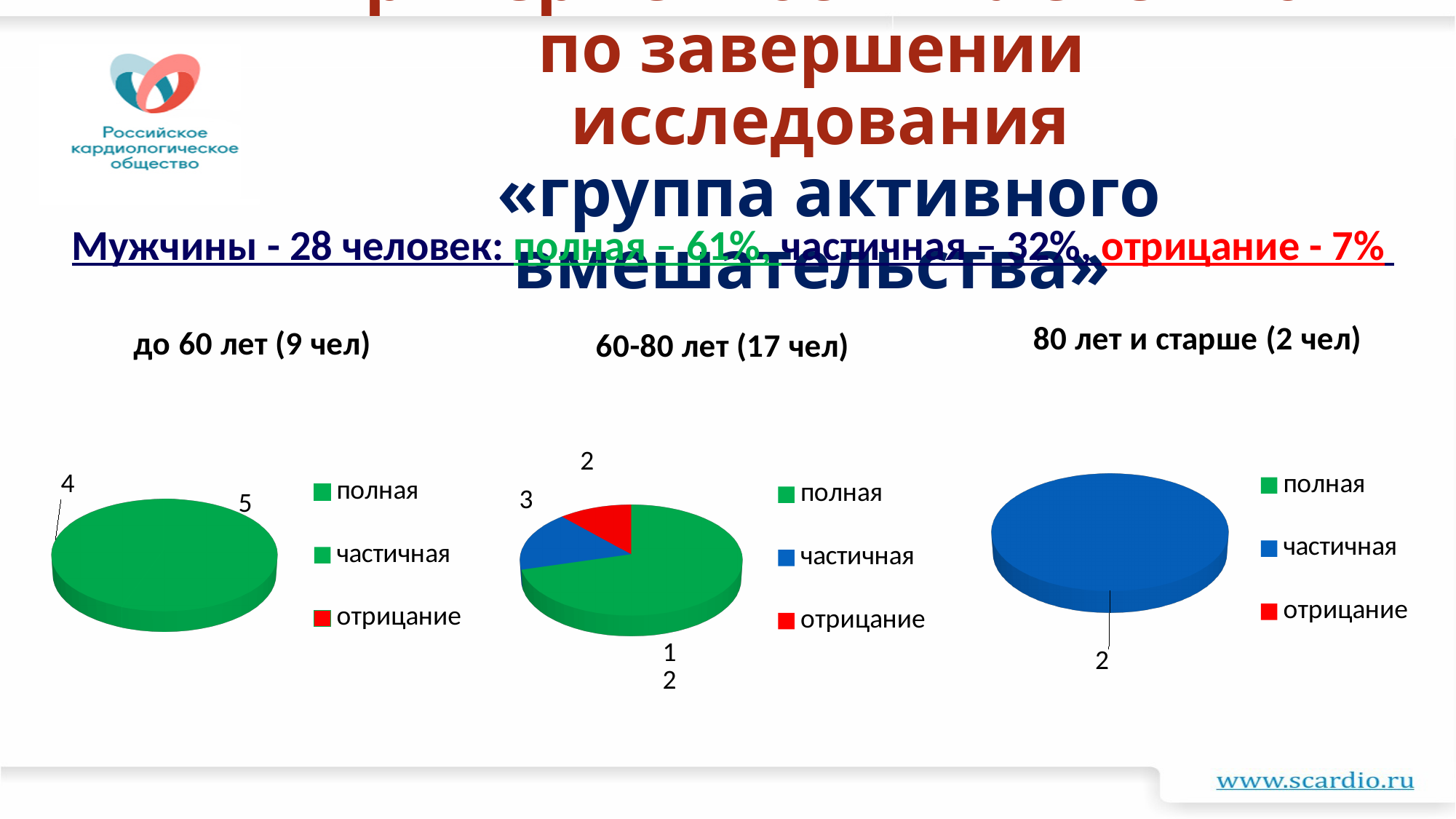
In the "60-80 лет (17 чел)" chart, what is the value for отрицание? 2 Which colour represents отрицание in the chart legends? red In the "60-80 лет (17 чел)" chart, which category has the largest slice? полная How many entries does the legend of the "до 60 лет (9 чел)" chart list? 3 In the "80 лет и старше (2 чел)" chart, what is the value for частичная? 2 What kind of chart is used for "60-80 лет (17 чел)"? pie chart In the "до 60 лет (9 чел)" chart, what is the total of the two labeled slices? 9 In the "60-80 лет (17 чел)" chart, what is the value for частичная? 3 In the "80 лет и старше (2 чел)" chart, what share of the pie does частичная take? 100% How many pie charts are shown on the slide? 3 In the "60-80 лет (17 чел)" chart, which is larger, частичная or отрицание? частичная In the "60-80 лет (17 чел)" chart, what is the difference between the values for частичная and отрицание? 1